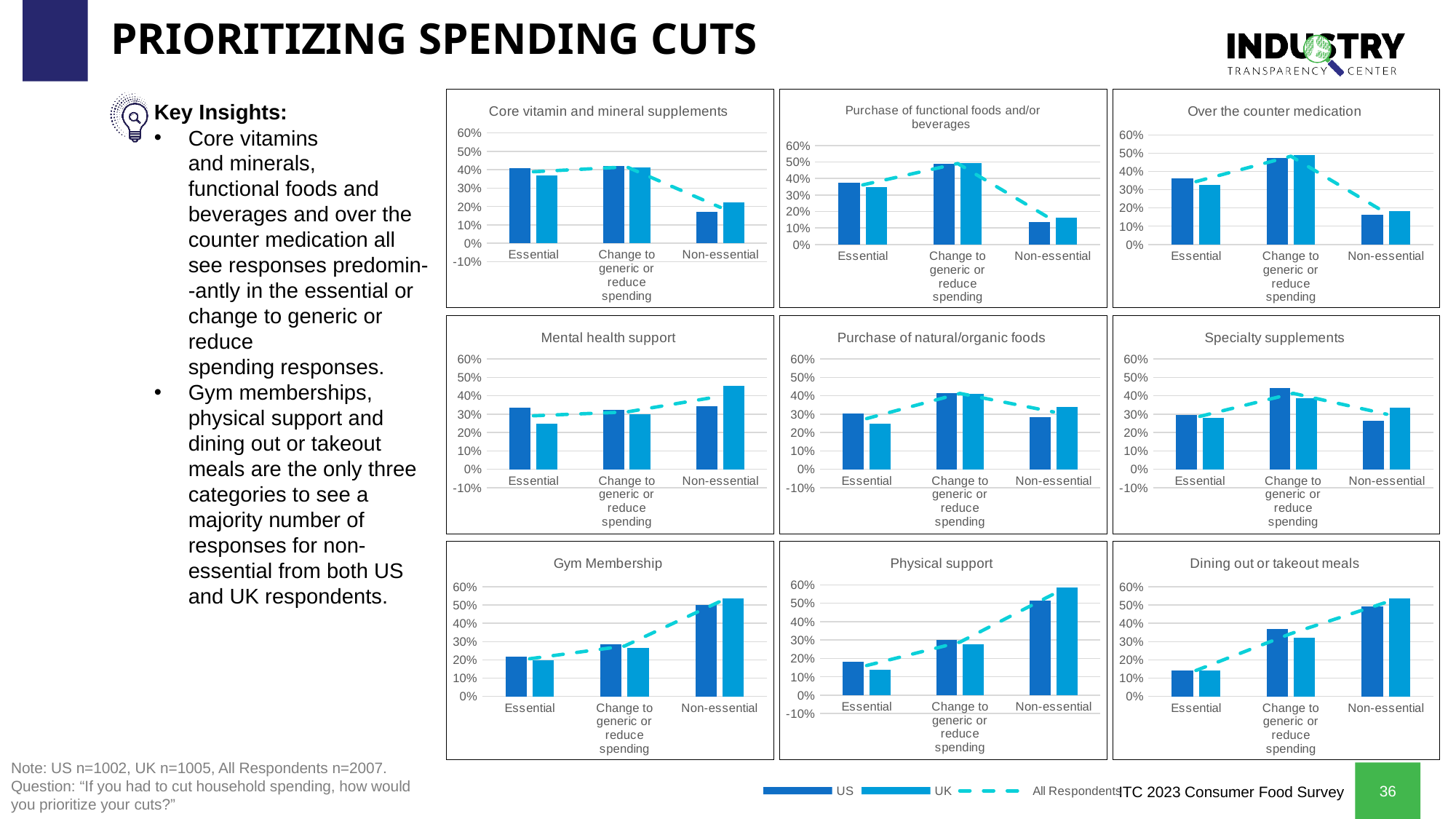
In the Purchase of functional foods and/or beverages chart, which category has the highest US bar? Change to generic or reduce spending According to the legend, what does the dashed line in each chart represent? All Respondents In the Mental health support chart, which is larger for the UK: Essential or Non-essential? Non-essential How many series does the legend at the bottom of the slide list? 3 In the Gym Membership chart, how many categories are shown on the x axis? 3 In the Dining out or takeout meals chart, which is larger for the US: Change to generic or reduce spending or Non-essential? Non-essential In the Gym Membership chart, is the UK value for Non-essential greater or less than 50%? greater What kind of chart is used to show the US and UK values in the Gym Membership chart? bar chart In the Core vitamin and mineral supplements chart, which category has the lowest UK bar? Non-essential In the Physical support chart, do the US bars rise or fall from Essential to Non-essential? rise In the Over the counter medication chart, is the UK value for Change to generic or reduce spending greater or less than 40%? greater In the Physical support chart, is the UK value for Essential greater or less than 20%? less